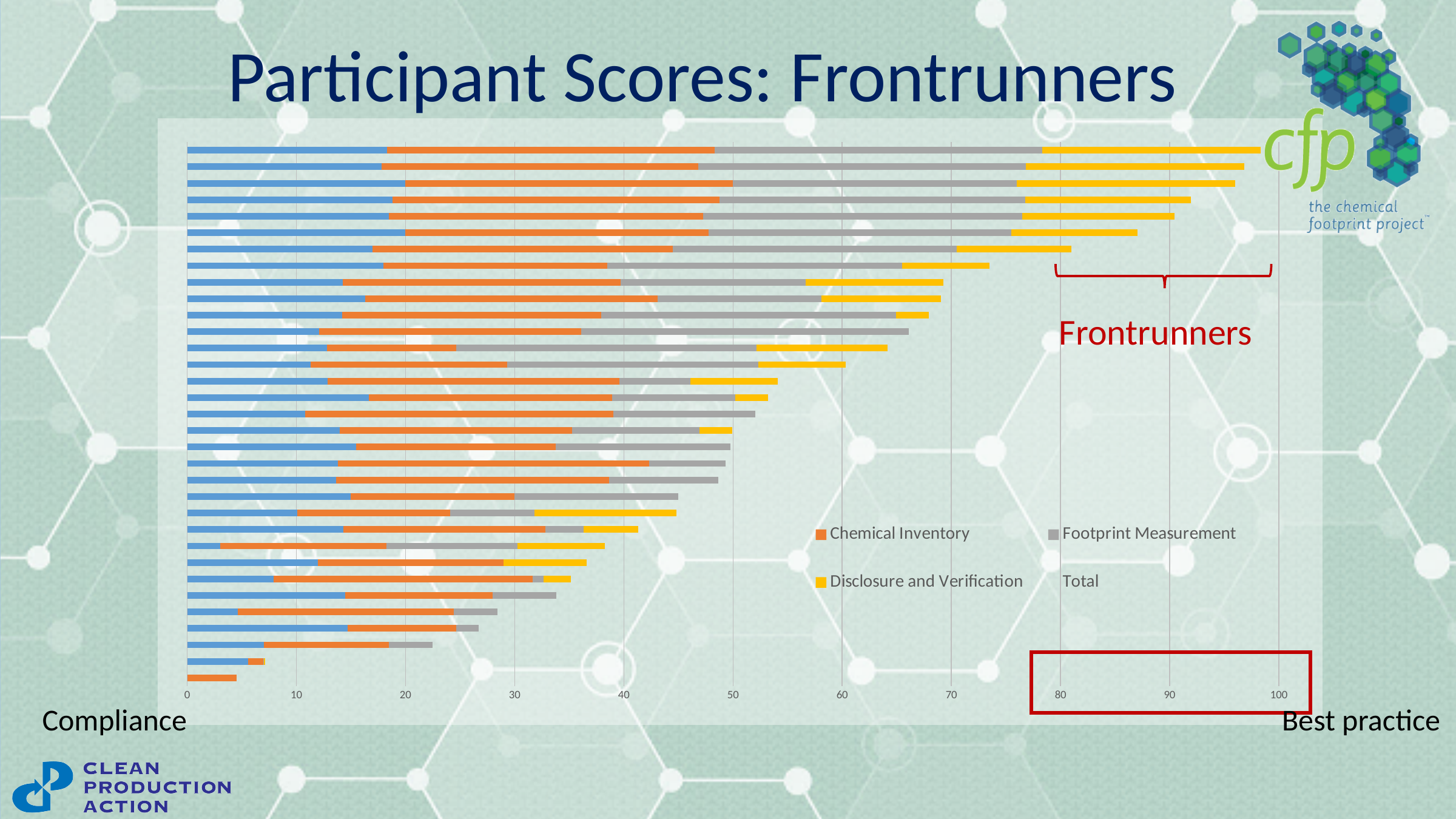
Which series is shown in orange in the chart's legend? Chemical Inventory Is the total value of the bottommost bar greater or less than 10? less What kind of chart is shown on the slide? Stacked horizontal bar chart Which is longer, the topmost bar or the bottommost bar? The topmost bar Is the total value of the second bar from the top greater or less than 90? greater Is the total value of the third bar from the top greater or less than 90? greater What is the title of the slide containing the chart? Participant Scores: Frontrunners How many series does the chart's legend list? 4 Do the bar totals increase or decrease going from the top of the chart to the bottom? decrease